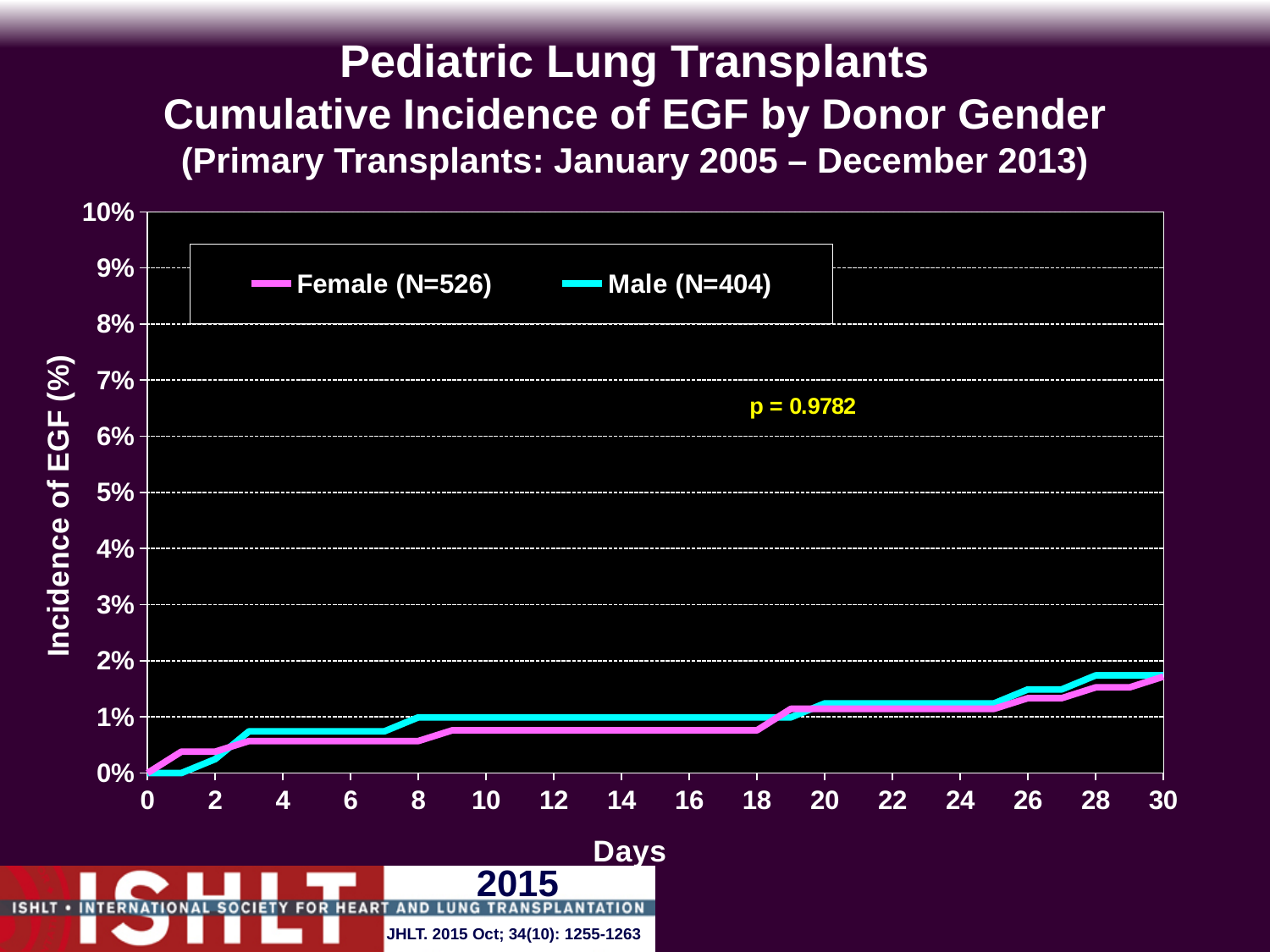
What is the highest value shown on the y axis? 10% Is the value for the Male series at day 30 greater or less than 2%? less Do the cumulative incidence values for the Female series rise or fall as days increase from 0 to 30? rise What are the two series named in the legend? Female (N=526) and Male (N=404) What kind of chart is shown on the slide? line chart What is the last day shown on the x axis? 30 Do the values for the Male series rise or fall between day 0 and day 30? rise How many series does the legend list? 2 Is the value for the Female series at day 4 greater or less than 1%? less Is the value for the Male series at day 20 greater or less than 5%? less What p-value is printed on the chart? p = 0.9782